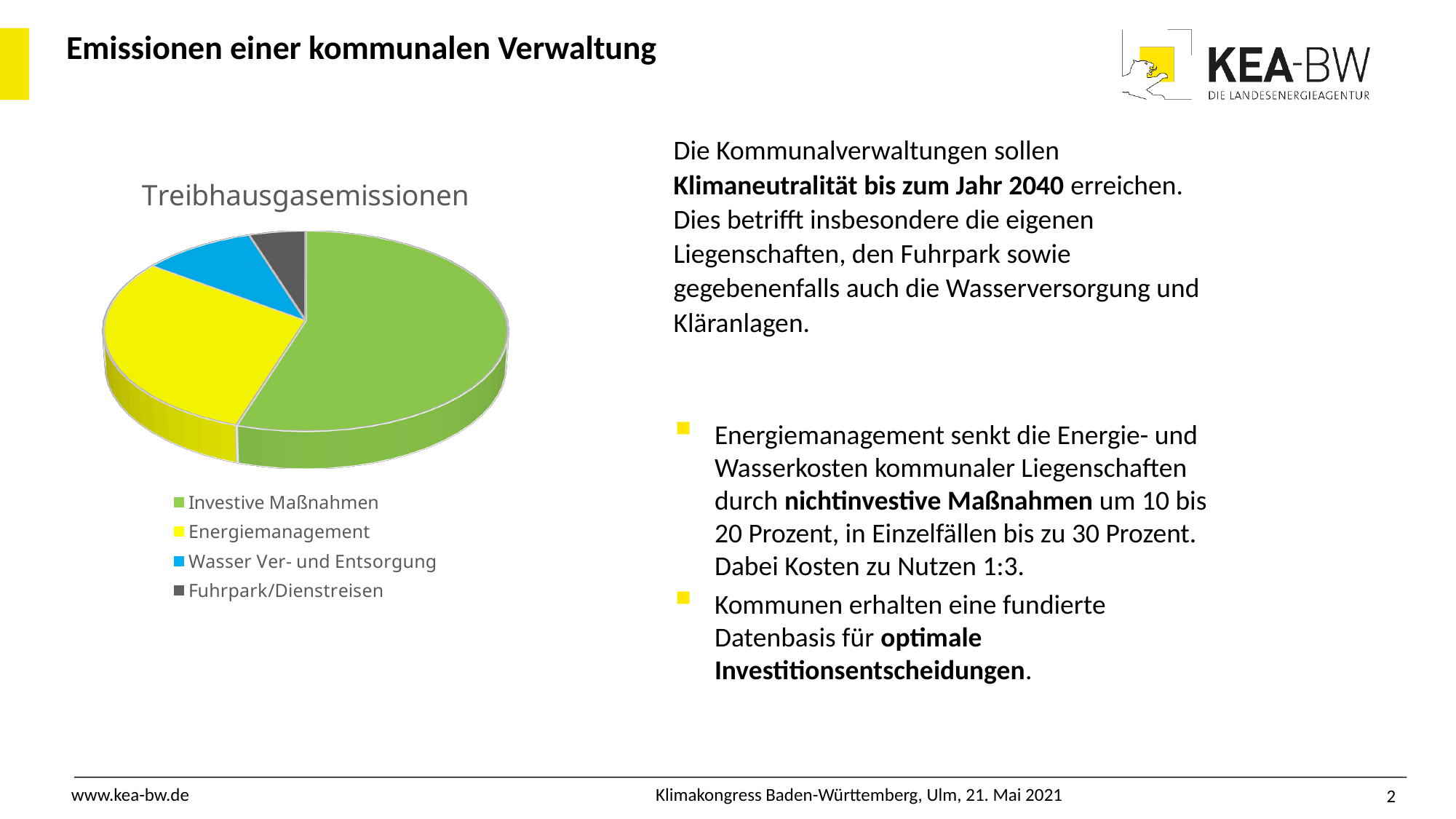
Which is larger in the pie chart, Energiemanagement or Wasser Ver- und Entsorgung? Energiemanagement Which is larger in the pie chart, Wasser Ver- und Entsorgung or Fuhrpark/Dienstreisen? Wasser Ver- und Entsorgung Which category has the smallest share of the pie chart? Fuhrpark/Dienstreisen What kind of chart is shown on the slide? Pie chart How many categories does the pie chart show? 4 Does the Investive Maßnahmen slice make up more or less than half of the pie chart? More What is the title of the chart? Treibhausgasemissionen Which category has the largest share of the pie chart? Investive Maßnahmen Which colour represents Energiemanagement in the pie chart? Yellow